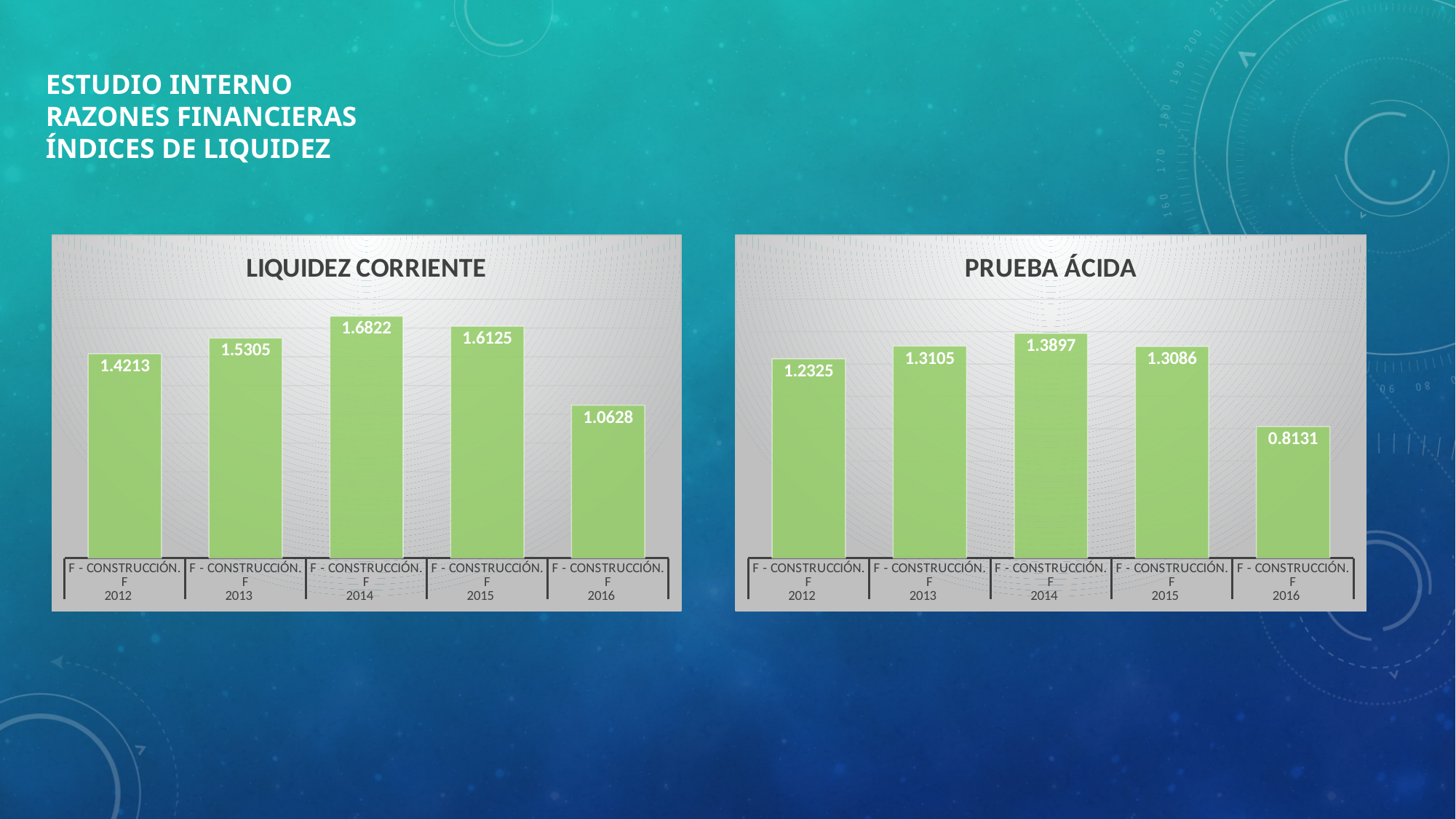
In the LIQUIDEZ CORRIENTE chart, what is the value for 2014? 1.6822 In the PRUEBA ÁCIDA chart, what is the difference between the 2013 and 2012 values? 0.0780 In the PRUEBA ÁCIDA chart, what is the value for 2016? 0.8131 In the LIQUIDEZ CORRIENTE chart, which is larger, the value for 2013 or the value for 2015? 2015 In the LIQUIDEZ CORRIENTE chart, which year has the lowest value? 2016 In the LIQUIDEZ CORRIENTE chart, does the value rise or fall from 2015 to 2016? Fall How many bars are shown in the PRUEBA ÁCIDA chart? 5 In the PRUEBA ÁCIDA chart, which year has the highest value? 2014 In the LIQUIDEZ CORRIENTE chart, what is the difference between the 2014 and 2016 values? 0.6194 What is the title of the chart on the right side of the slide? PRUEBA ÁCIDA What kind of chart is the LIQUIDEZ CORRIENTE chart? Bar chart In the PRUEBA ÁCIDA chart, which is larger, the value for 2012 or the value for 2016? 2012